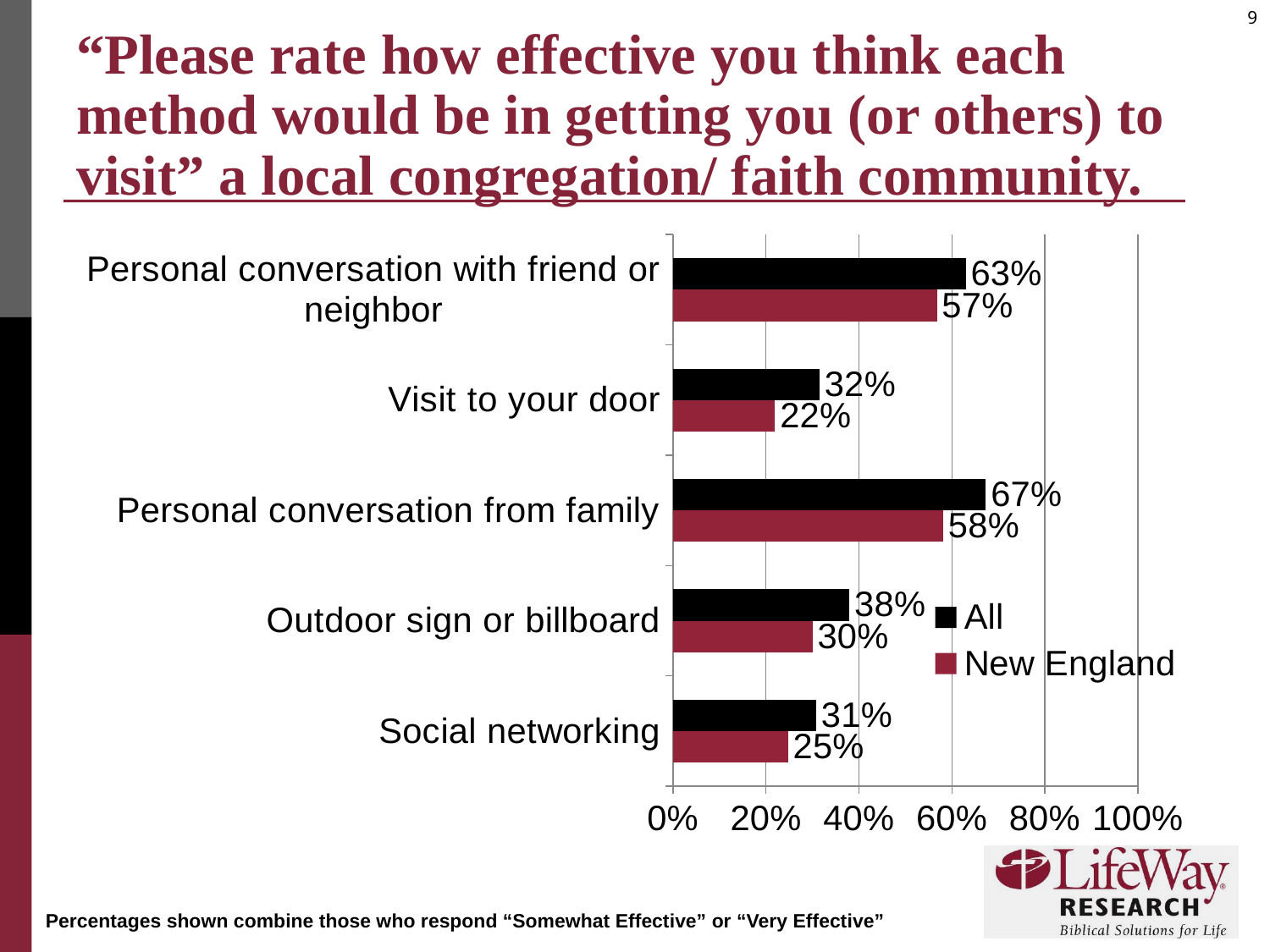
How many series does the legend list? 2 Which method has the lowest value for "New England"? Visit to your door What is the value for "New England" for Personal conversation from family? 58% What kind of chart is shown on the slide? Bar chart How many methods are shown on the chart? 5 Which is larger: the "All" value for Outdoor sign or billboard or the "All" value for Social networking? Outdoor sign or billboard Which colour represents the "New England" series? Red Which method has the highest value for "All"? Personal conversation from family What is the difference between the "All" values for Personal conversation from family and Outdoor sign or billboard? 29% What is the value for "All" for Personal conversation with friend or neighbor? 63% What is the difference between the "All" and "New England" values for Visit to your door? 10% What is the value for "New England" for Visit to your door? 22%